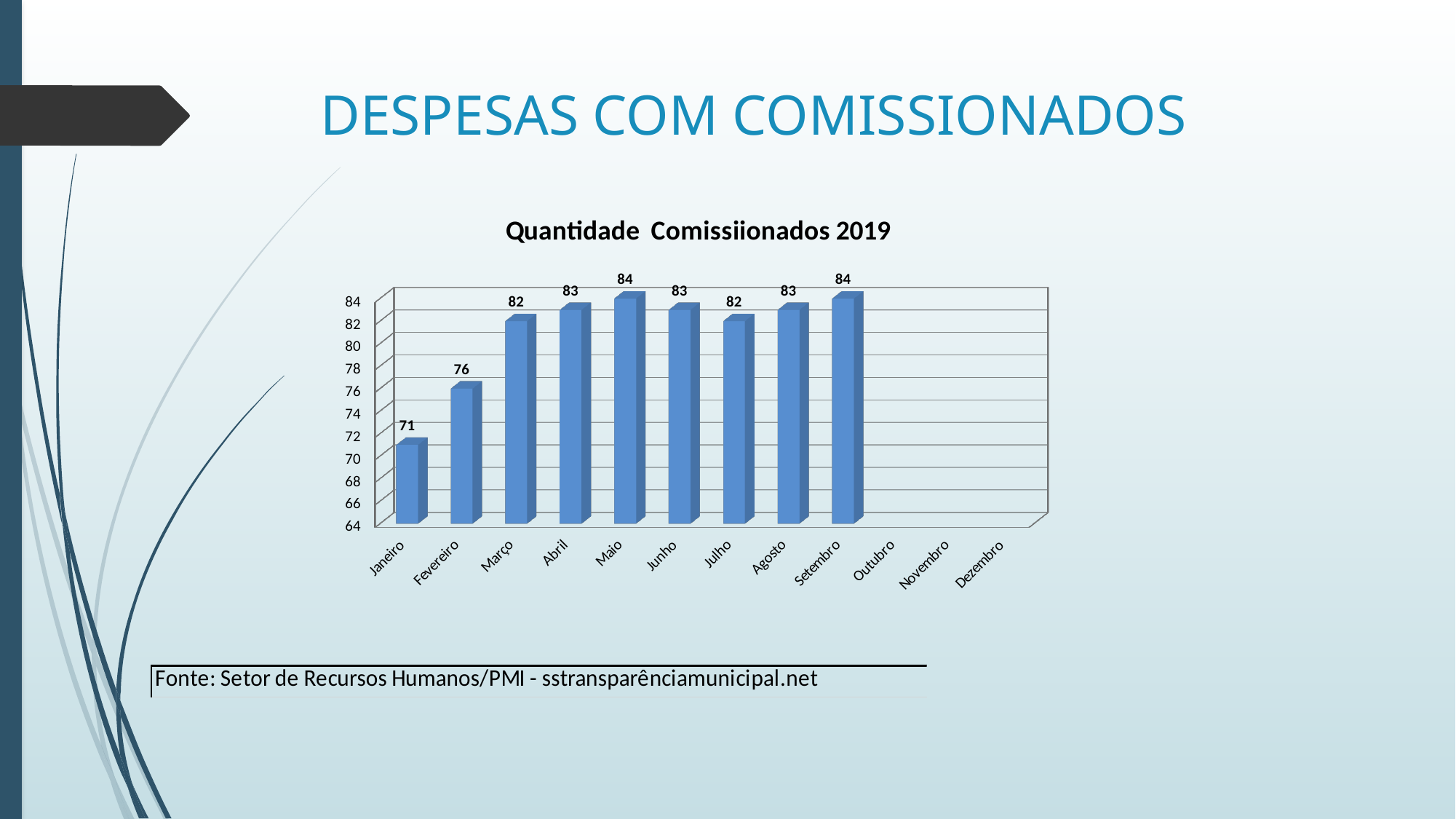
What kind of chart is shown on the slide? Bar chart Which month has the lowest value? Janeiro What is the value for Janeiro? 71 What is the difference between the values for Maio and Janeiro? 13 Do the values rise or fall from Janeiro to Maio? Rise What is the value for Setembro? 84 What is the highest value shown on the chart? 84 What is the value for Julho? 82 What is the value for Fevereiro? 76 What is the title of the chart? Quantidade Comissiionados 2019 Which is larger, the value for Março or the value for Fevereiro? Março How many months have a bar plotted on the chart? 9